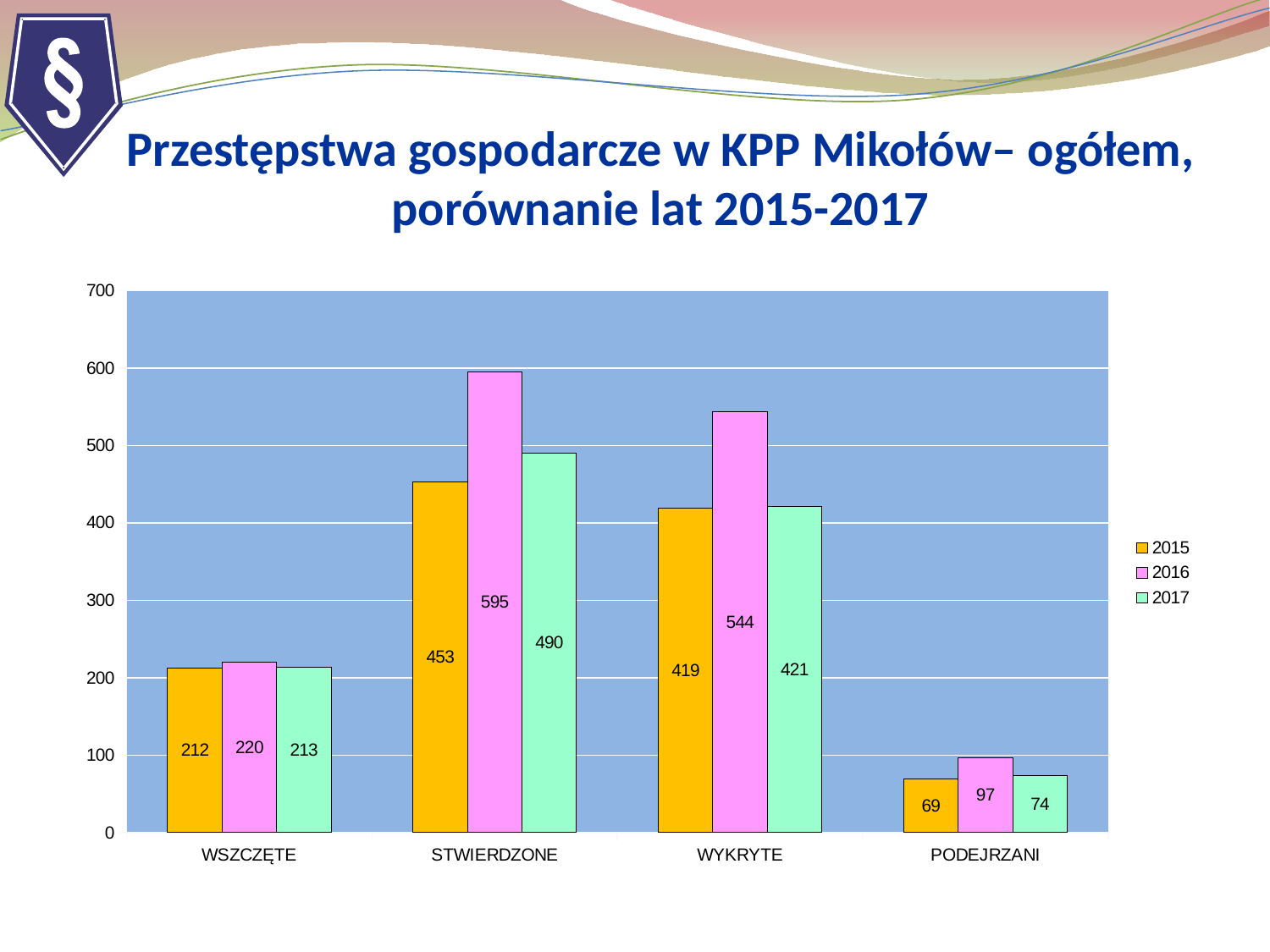
What is the value for PODEJRZANI in 2015? 69 Which year does the legend associate with the pink bars? 2016 What is the value for WYKRYTE in 2017? 421 How many categories are shown on the x axis? 4 Which is larger for STWIERDZONE: the 2015 value or the 2017 value? 2017 What is the value for STWIERDZONE in 2016? 595 Which category has the lowest value in 2017? PODEJRZANI What is the difference between the 2016 and 2015 values for WYKRYTE? 125 Which category has the highest value in 2016? STWIERDZONE What kind of chart is shown on the slide? bar chart Is the value for WYKRYTE in 2016 greater or less than 500? greater How many series does the legend list? 3